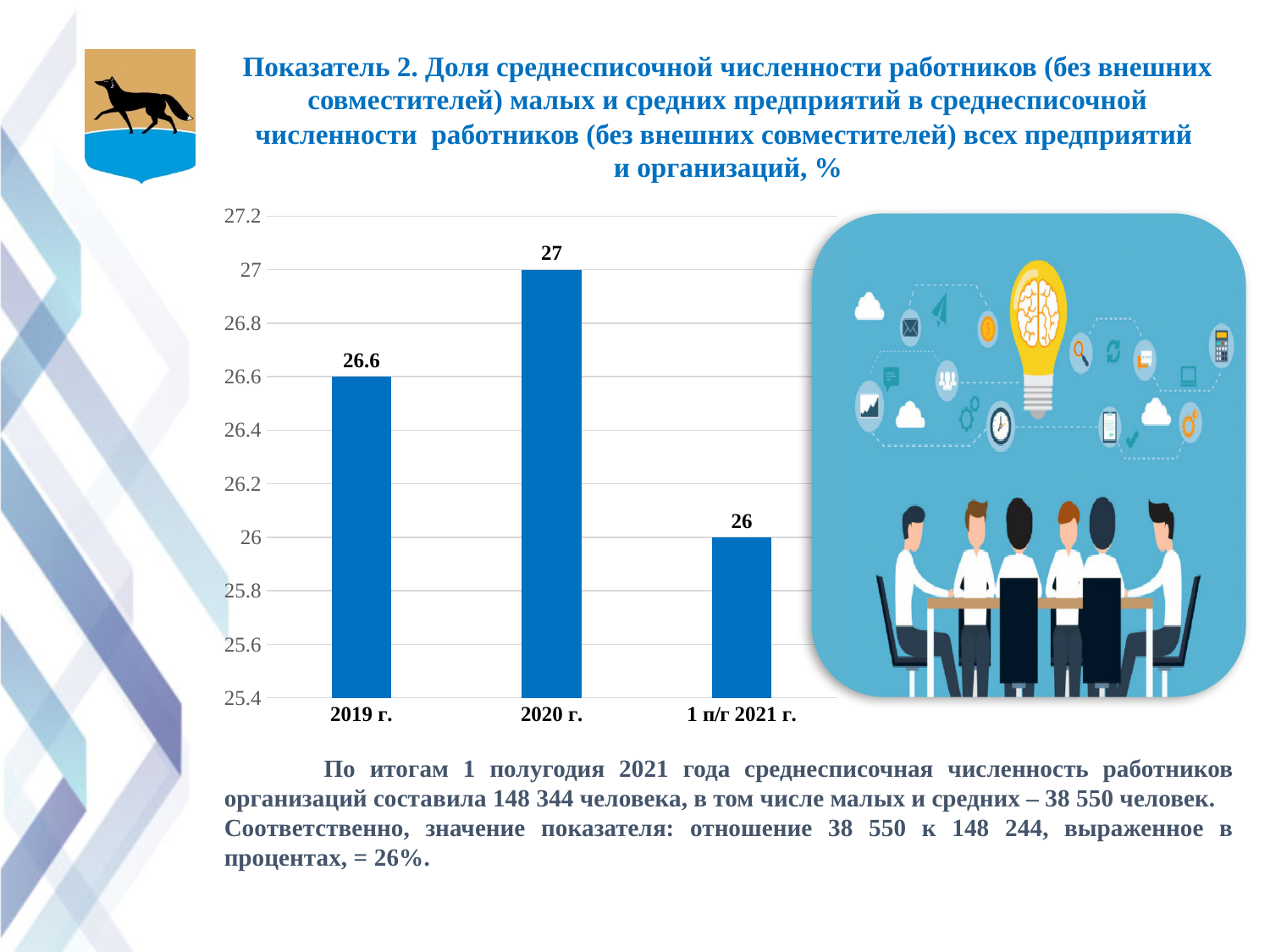
Is the value for 2019 г. greater or less than 26.4? greater Which category has the lowest value? 1 п/г 2021 г. What is the value for 1 п/г 2021 г.? 26 How many categories are shown on the x axis? 3 What is the lowest value shown on the vertical axis? 25.4 Which is larger, the value for 2019 г. or the value for 1 п/г 2021 г.? 2019 г. Which category has the highest value? 2020 г. What kind of chart is shown on the slide? bar chart What is the value for 2020 г.? 27 What is the value for 2019 г.? 26.6 What is the difference between the values for 2020 г. and 2019 г.? 0.4 What is the difference between the values for 2020 г. and 1 п/г 2021 г.? 1